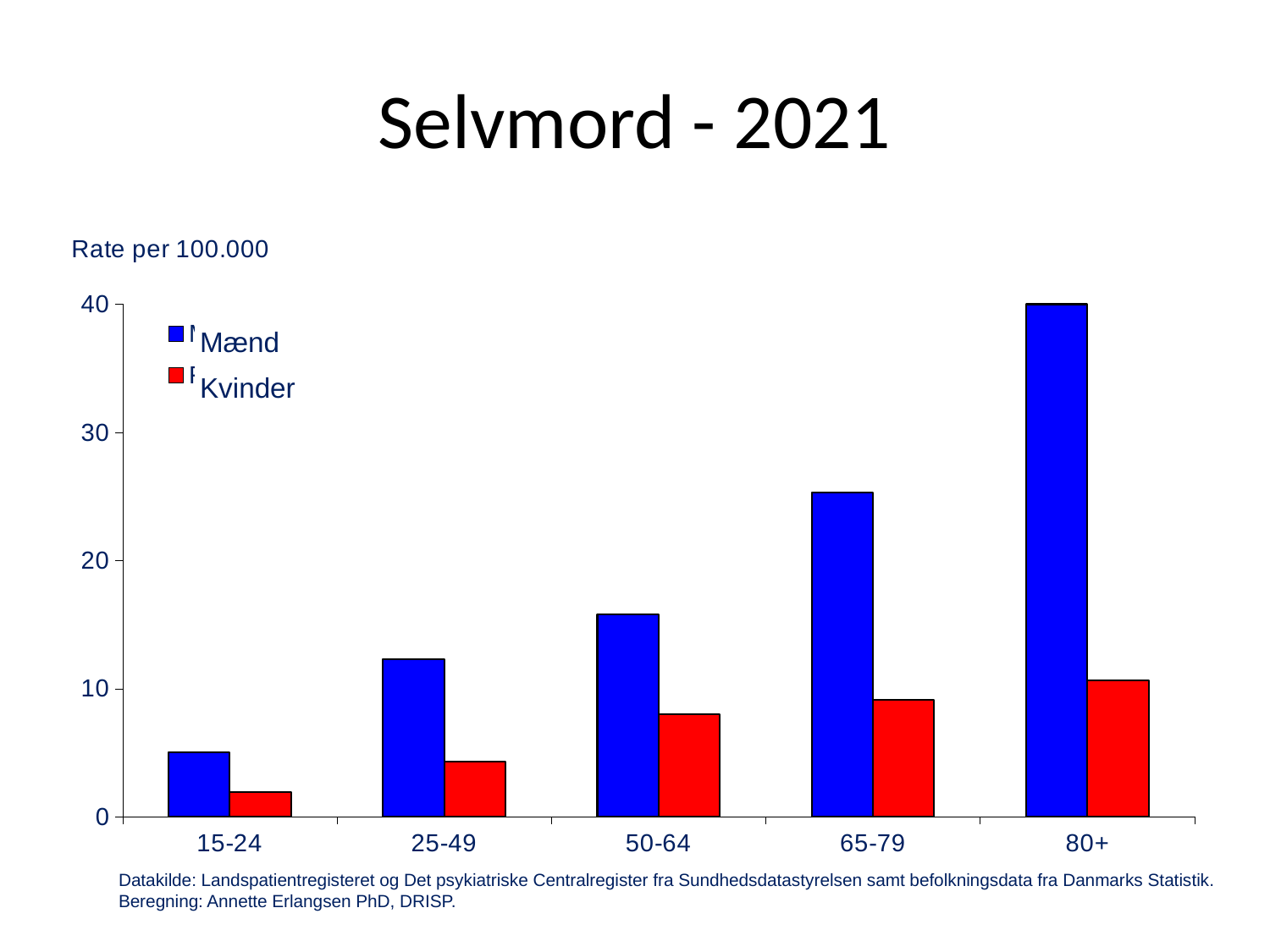
Is the value for Mænd in the 50-64 age group greater or less than 20? less Is the value for Kvinder in the 65-79 age group greater or less than 10? less Is the value for Mænd in the 65-79 age group greater or less than 20? greater Which age group has the highest value for Mænd? 80+ What is the title of the chart? Selvmord - 2021 How many series does the legend list? 2 In the 80+ age group, which is larger, the value for Mænd or for Kvinder? Mænd What kind of chart is shown on the slide? bar chart How many age groups are shown on the x axis? 5 Do the values for Mænd rise or fall as the age groups increase along the x axis? rise Which age group has the lowest value for Kvinder? 15-24